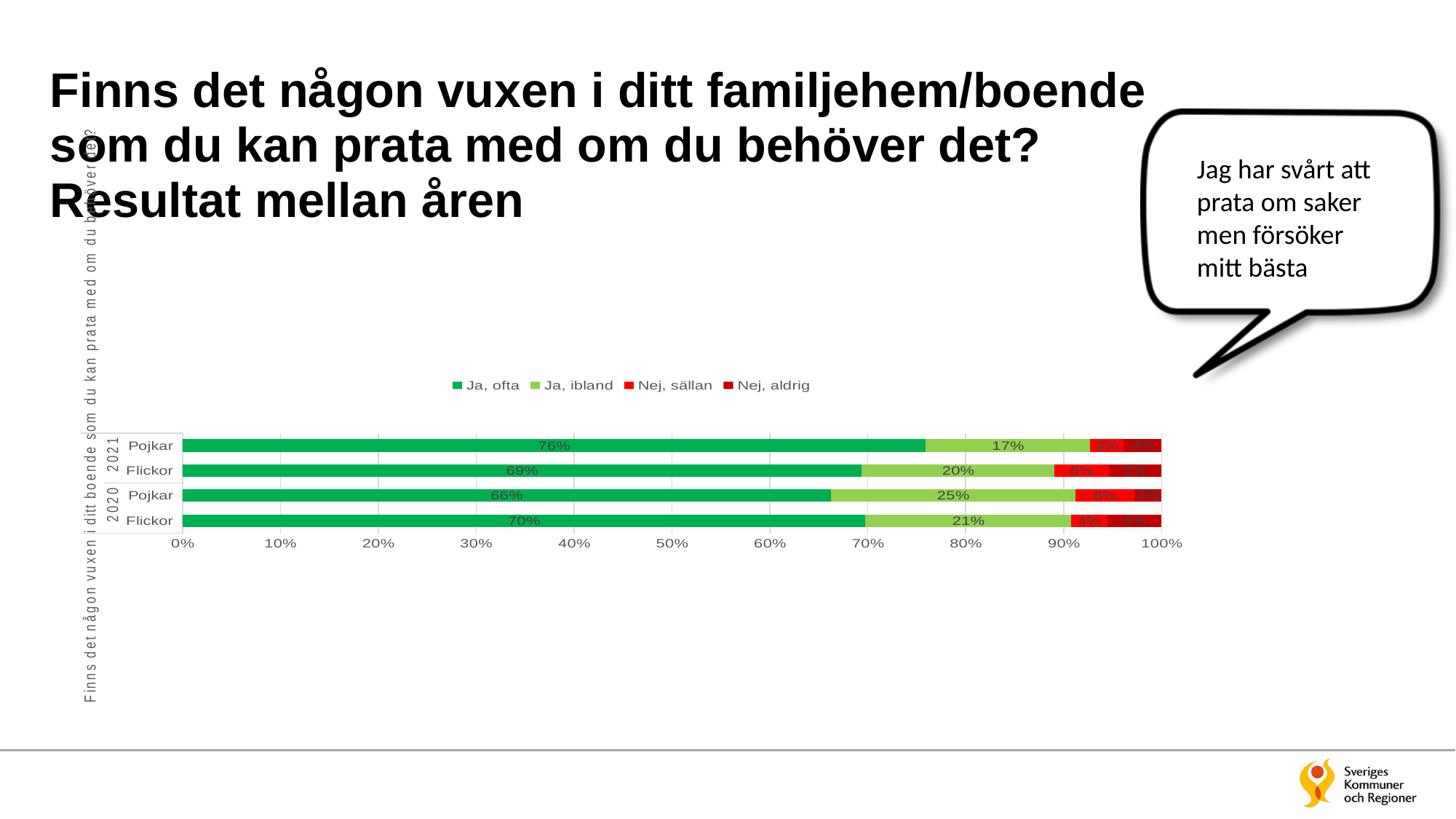
Which is larger: the "Ja, ibland" share for Flickor in 2021 or for Flickor in 2020? Flickor 2020 What percentage of Flickor in 2020 answered "Ja, ofta"? 70% What is the difference in percentage points between the "Ja, ofta" share for Pojkar in 2021 and Pojkar in 2020? 10 percentage points What percentage of Pojkar in 2021 answered "Ja, ofta"? 76% How many bars are shown in the chart? 4 What percentage of Flickor in 2021 answered "Nej, sällan"? 6% What kind of chart is shown on the slide? Stacked bar chart How many series does the legend list? 4 Which group has the lowest share answering "Ja, ofta"? Pojkar 2020 Which group has the highest share answering "Ja, ofta"? Pojkar 2021 Is the "Ja, ofta" share for Pojkar in 2021 greater or less than 70%? greater What percentage of Pojkar in 2020 answered "Ja, ibland"? 25%